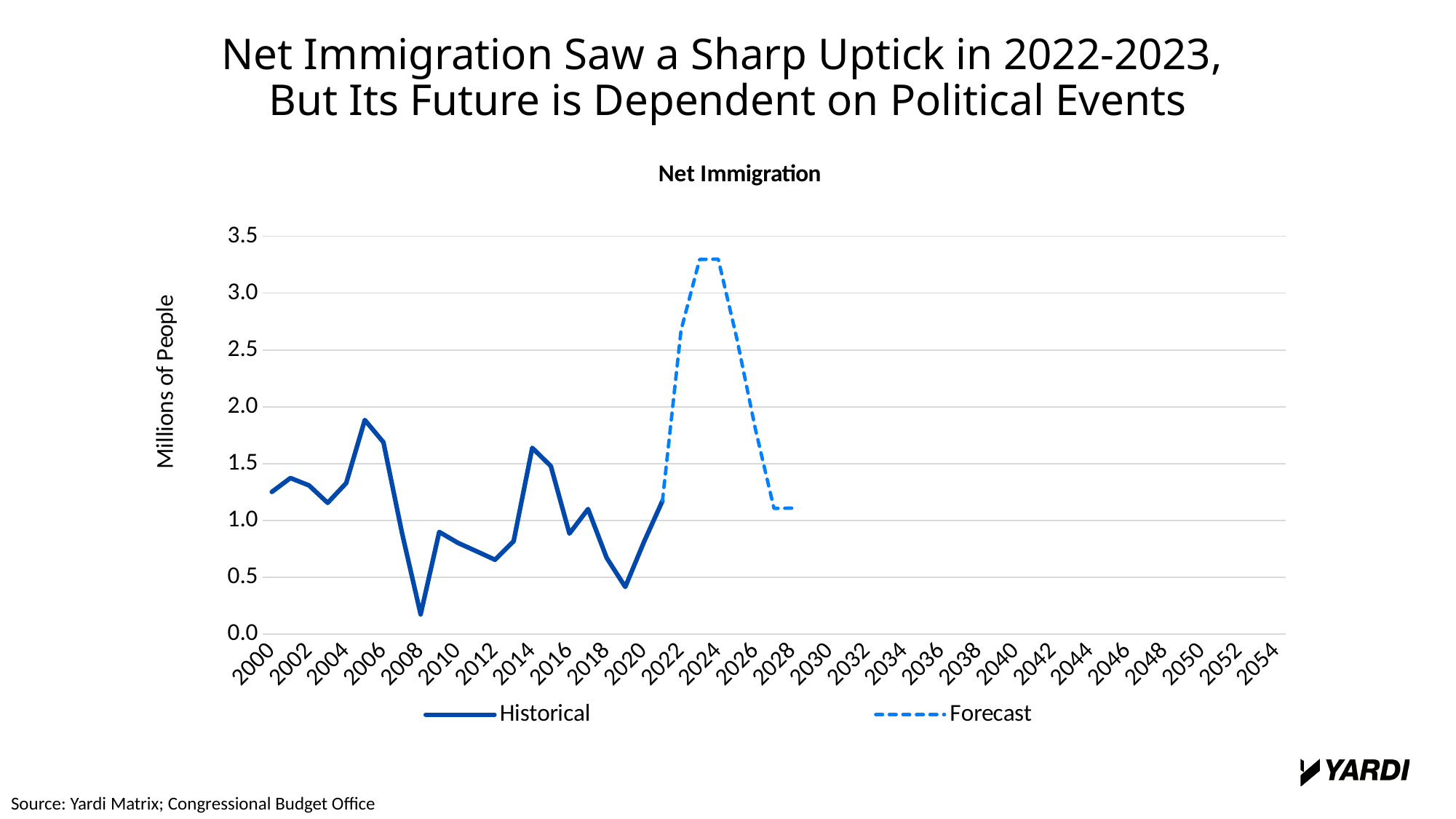
Is the Historical value for 2008 greater or less than 0.5? less In which year does the Historical series reach its lowest value? 2008 Does the Historical series rise or fall between 2006 and 2008? fall What kind of chart is shown on the slide? line chart What are the two series named in the legend? Historical and Forecast Is the peak of the Forecast series greater or less than 3.0? greater Is the Historical value for 2012 greater or less than 1.0? less In which year does the Historical series reach its highest value? 2005 What is the y-axis label of the chart? Millions of People How many series does the legend list? 2